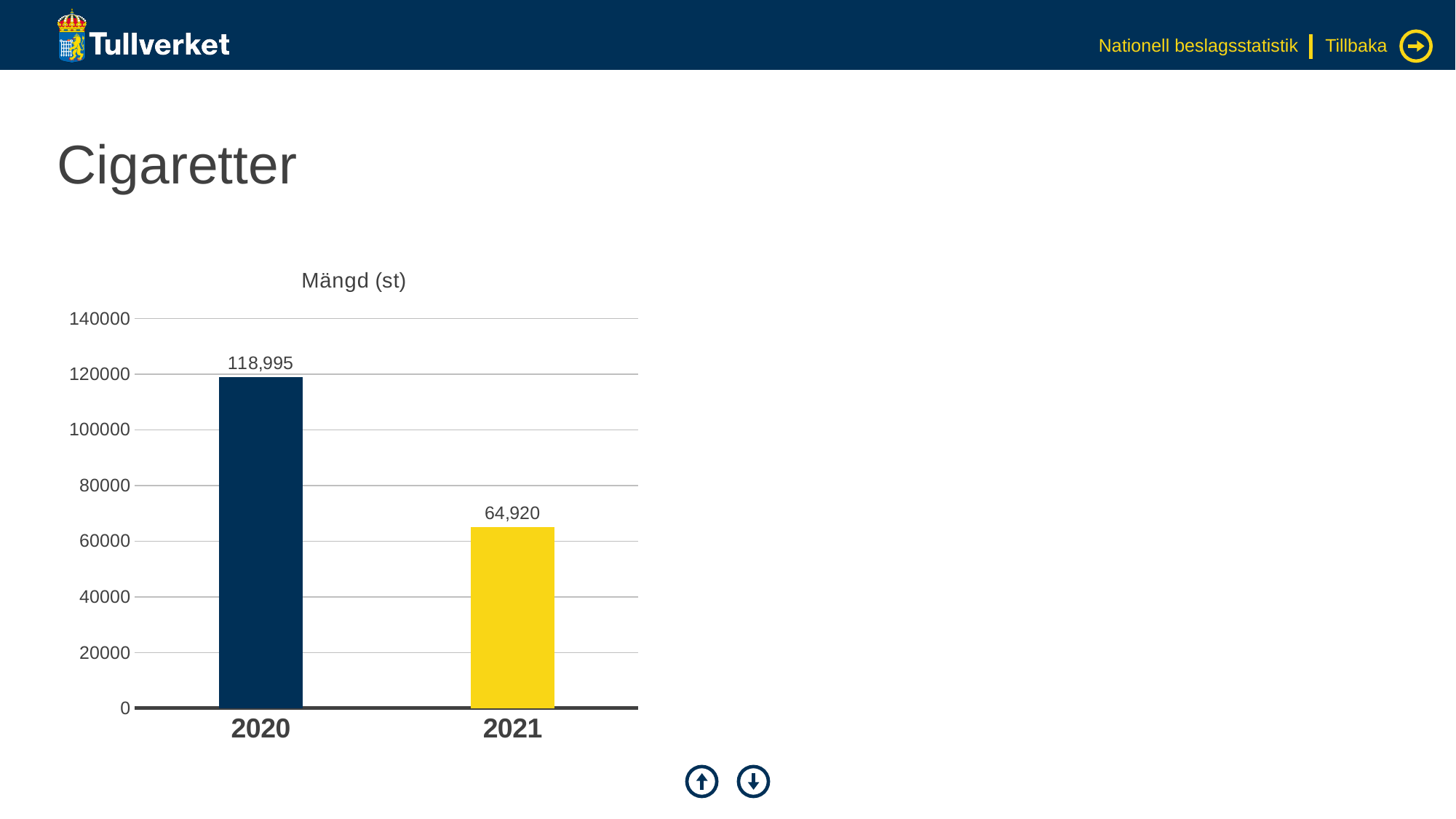
What is the title of the chart? Mängd (st) Do the values rise or fall from 2020 to 2021? fall Which year has the lowest value? 2021 Which is larger, the value for 2020 or the value for 2021? 2020 Is the value for 2021 greater or less than 80000? less What kind of chart is shown on the slide? bar chart What is the value for 2020? 118,995 What is the value for 2021? 64,920 What is the difference between the values for 2020 and 2021? 54,075 How many years are shown on the chart? 2 Which year has the highest value? 2020 Is the value for 2020 greater or less than 100000? greater